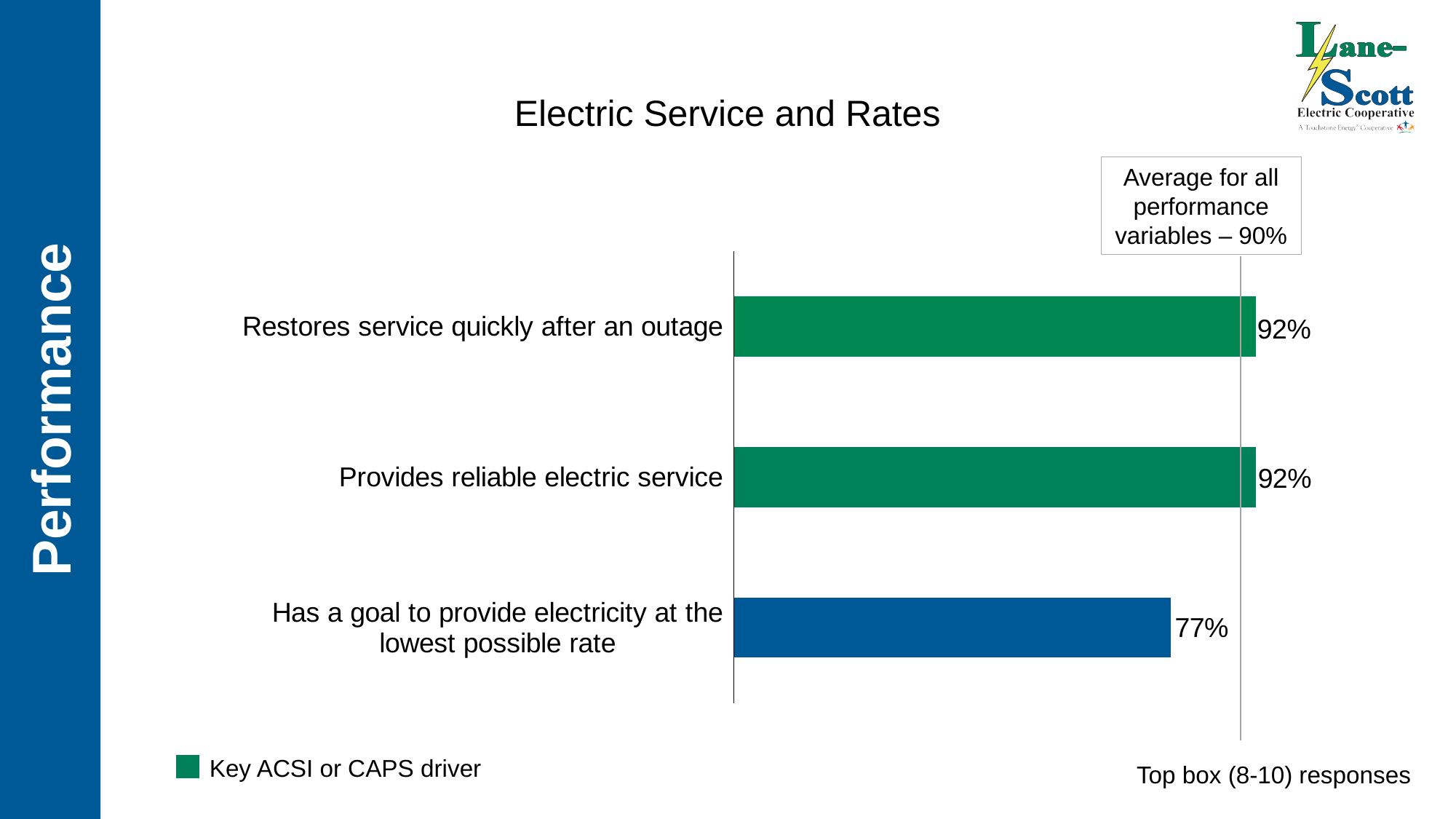
Is the value for "Has a goal to provide electricity at the lowest possible rate" greater or less than the 90% average line? less What is the title of the chart? Electric Service and Rates Is the value for "Provides reliable electric service" greater or less than the 90% average line? greater What is the value for "Has a goal to provide electricity at the lowest possible rate"? 77% Which category has the lowest value? Has a goal to provide electricity at the lowest possible rate Which is larger: the value for "Restores service quickly after an outage" or the value for "Has a goal to provide electricity at the lowest possible rate"? Restores service quickly after an outage What is the difference between the value for "Provides reliable electric service" and the value for "Has a goal to provide electricity at the lowest possible rate"? 15% What is the average for all performance variables shown on the slide? 90% What is the value for "Restores service quickly after an outage"? 92% What kind of chart is shown on the slide? Bar chart How many categories are shown in the chart? 3 What is the value for "Provides reliable electric service"? 92%